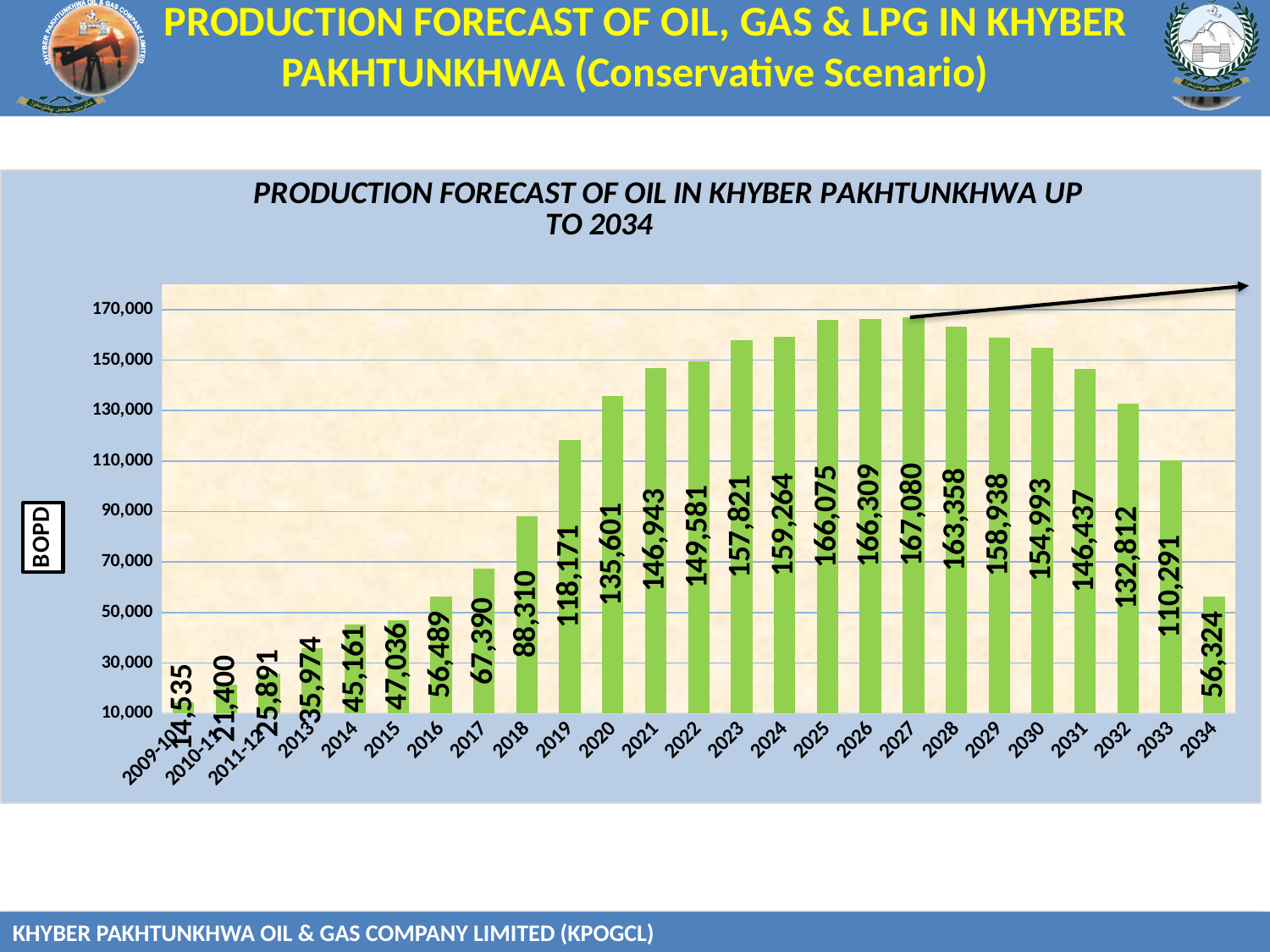
What is the forecast oil production value for 2025? 166,075 Is the value for 2016 greater or less than 50,000? greater Do the values rise or fall from 2009-10 to 2027? rise What is the forecast oil production value for 2034? 56,324 What is the forecast oil production value for 2020? 135,601 Which year has the highest forecast oil production? 2027 What is the difference between the values for 2027 and 2034? 110,756 Which year has the larger value, 2019 or 2031? 2031 What is the difference between the values for 2026 and 2025? 234 Which category has the lowest oil production value? 2009-10 How many categories are shown on the x axis? 25 What kind of chart is shown on the slide? bar chart